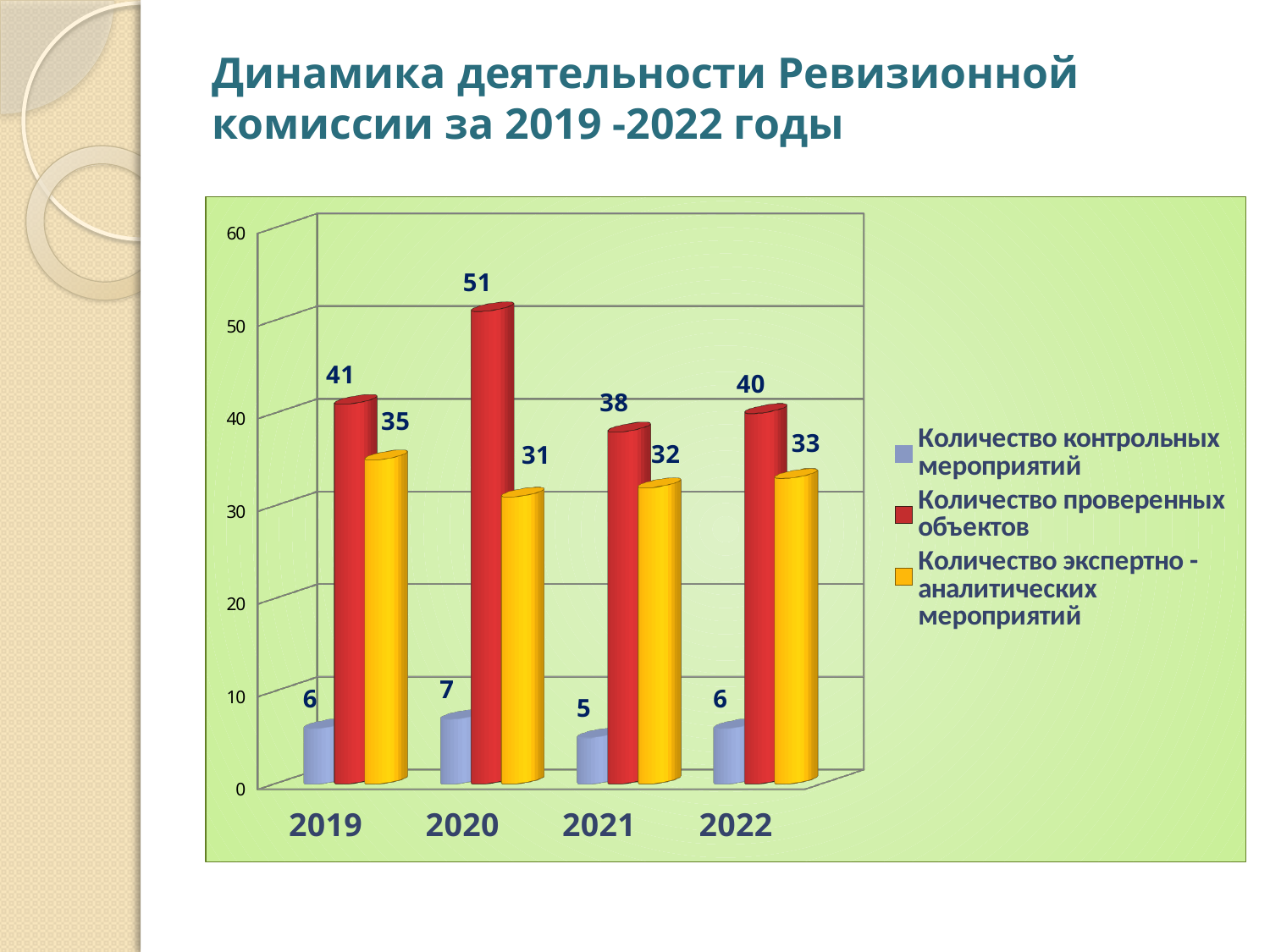
What kind of chart is shown on the slide? bar chart What is the difference between "Количество проверенных объектов" in 2020 and in 2019? 10 What is the value of "Количество контрольных мероприятий" for 2021? 5 How many years are shown on the x axis? 4 Does "Количество проверенных объектов" rise or fall from 2020 to 2021? fall Which is larger: "Количество экспертно - аналитических мероприятий" in 2022 or in 2021? 2022 What is the value of "Количество экспертно - аналитических мероприятий" for 2019? 35 How many series does the legend list? 3 What is the value of "Количество проверенных объектов" for 2020? 51 What colour are the bars for "Количество контрольных мероприятий"? blue In which year is "Количество проверенных объектов" highest? 2020 In which year is "Количество экспертно - аналитических мероприятий" lowest? 2020